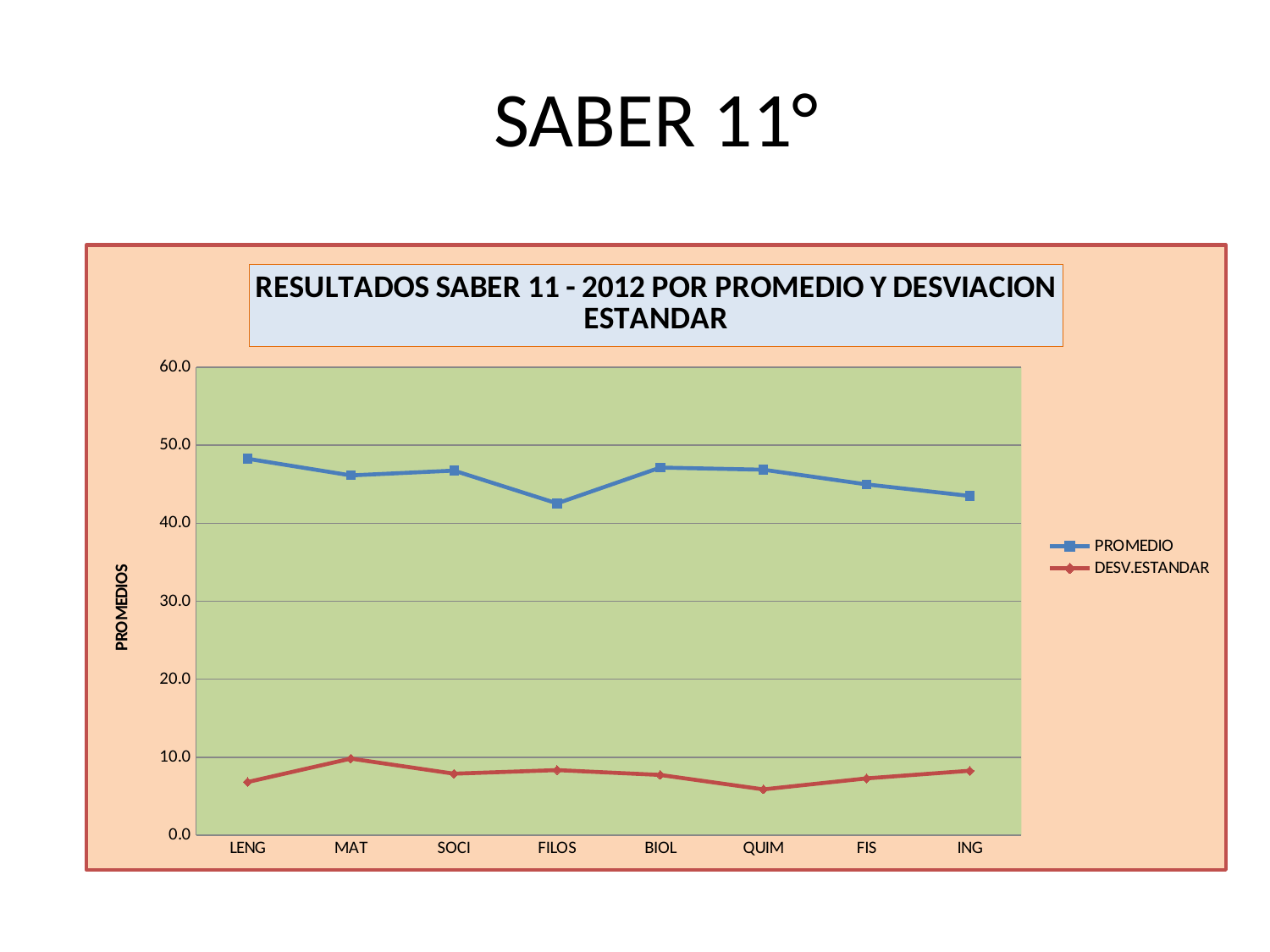
What is the label on the vertical axis? PROMEDIOS Which category has the highest DESV.ESTANDAR value? MAT How many series does the legend list? 2 Which category has the lowest PROMEDIO value? FILOS Is the PROMEDIO value for FILOS greater or less than 40.0? greater Which category has the lowest DESV.ESTANDAR value? QUIM What kind of chart is shown on the slide? line chart Which category has the highest PROMEDIO value? LENG How many categories are shown on the x axis? 8 From BIOL to ING, does the PROMEDIO line rise or fall? fall Which is larger, the PROMEDIO value for LENG or for MAT? LENG Is the DESV.ESTANDAR value for QUIM greater or less than 10.0? less